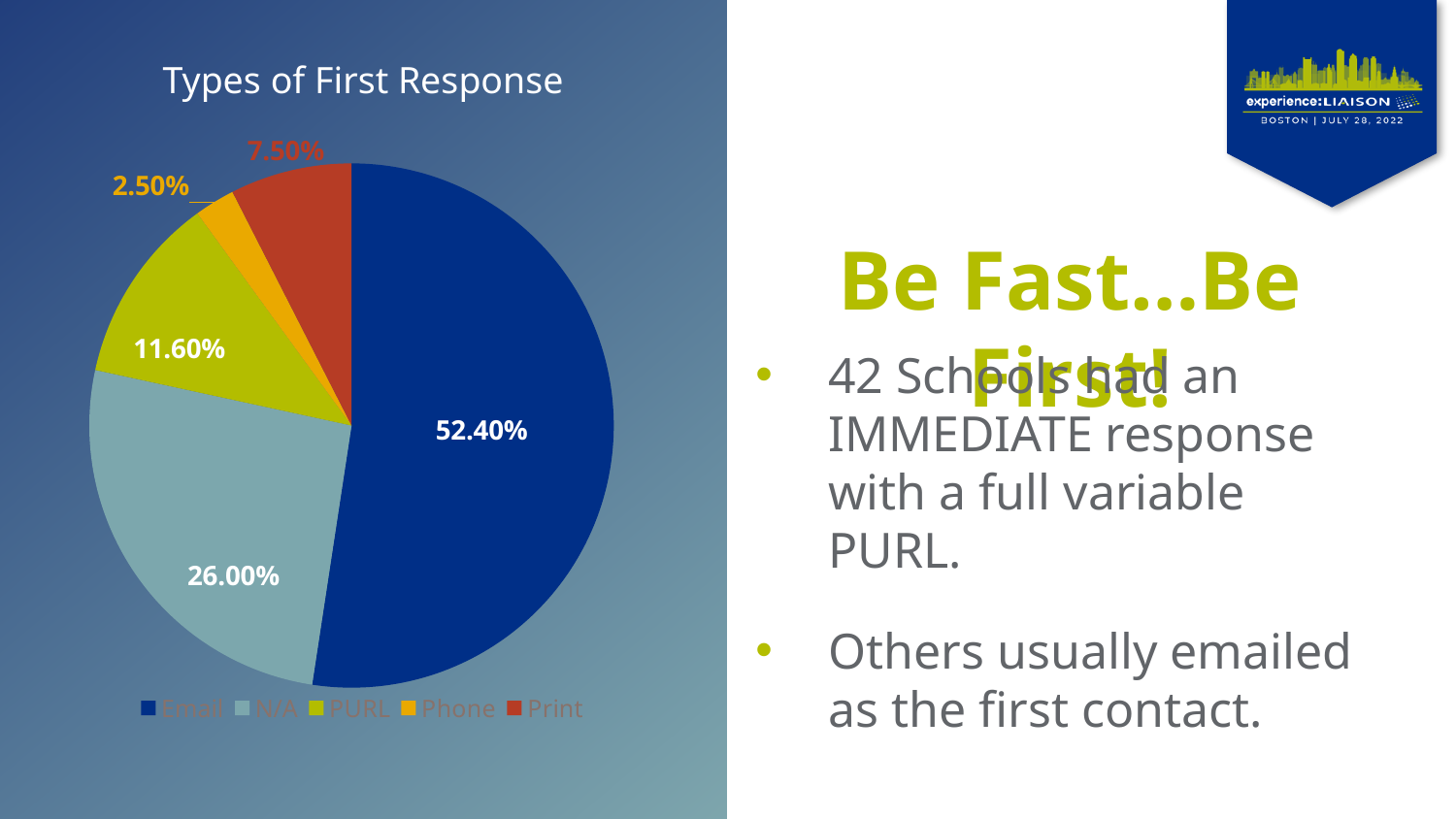
What kind of chart is shown on the slide? pie chart What is the title of the chart? Types of First Response How many categories does the legend list? 5 Which type of first response has the smallest share of the pie? Phone What percentage of first responses were Phone? 2.50% What percentage of first responses were Email? 52.40% What percentage of first responses were Print? 7.50% What is the difference in percentage points between Email and N/A? 26.40% Which type of first response has the largest share of the pie? Email What percentage of first responses were N/A? 26.00% Which is larger, the share for Print or the share for PURL? PURL What percentage of first responses were PURL? 11.60%